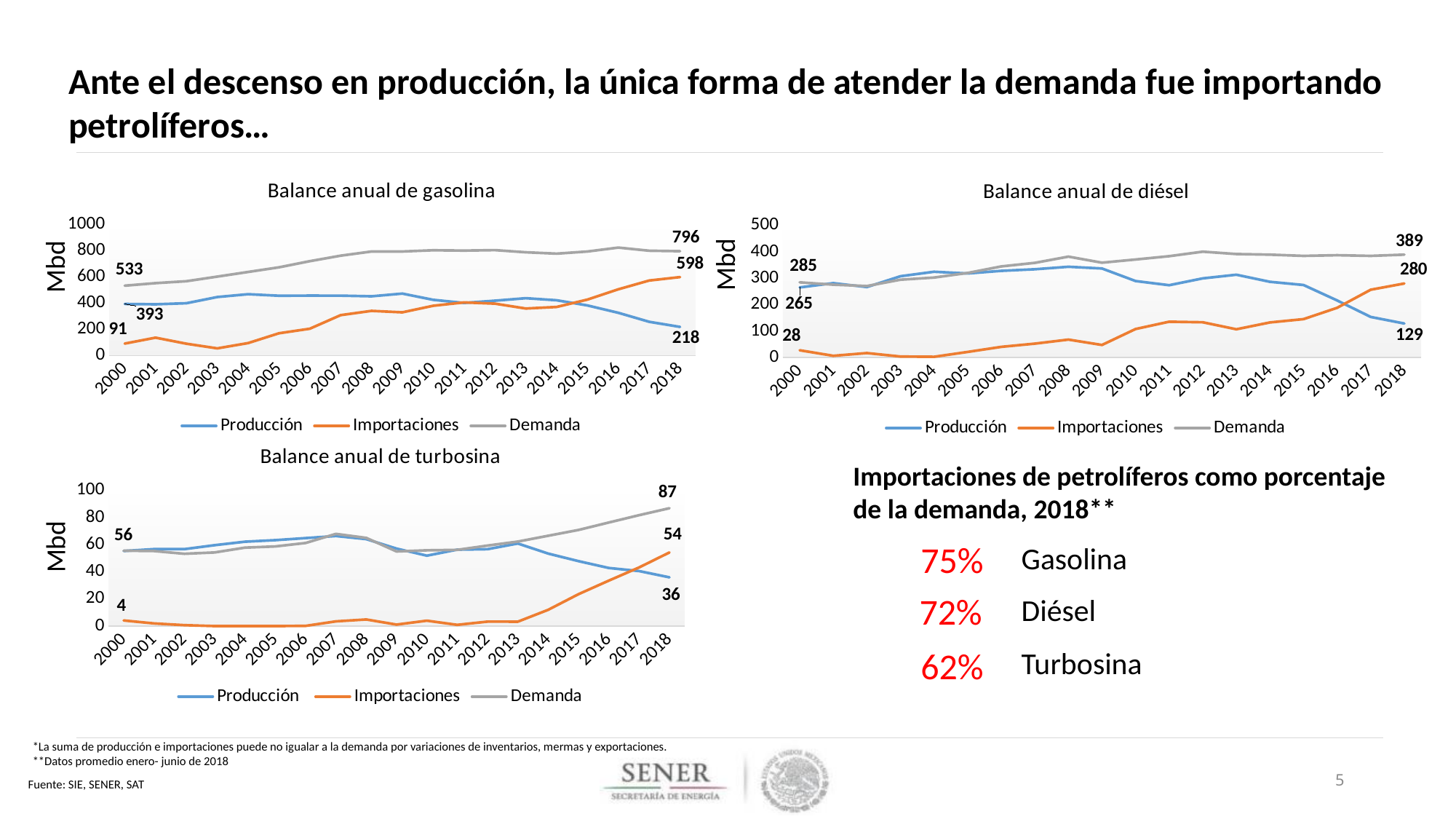
What kind of chart is 'Balance anual de turbosina'? line chart In the 'Balance anual de turbosina' chart, is the value of Producción in 2010 greater or less than 60? less In the 'Balance anual de turbosina' chart, what is the value of Demanda in 2018? 87 In the 'Balance anual de gasolina' chart, does Producción rise or fall between 2000 and 2018? fall In the 'Balance anual de gasolina' chart, what is the value of Demanda in 2018? 796 In the 'Balance anual de diésel' chart, which is larger in 2018, Importaciones or Producción? Importaciones In the 'Balance anual de diésel' chart, how many series does the legend list? 3 In the 'Balance anual de gasolina' chart, what is the value of Importaciones in 2000? 91 In the 'Balance anual de diésel' chart, what is the value of Producción in 2018? 129 In the 'Balance anual de gasolina' chart, what is the difference between Importaciones and Producción in 2018? 380 In the 'Balance anual de diésel' chart, what is the value of Importaciones in 2000? 28 In the 'Balance anual de turbosina' chart, what is the difference between Demanda in 2018 and Demanda in 2000? 31